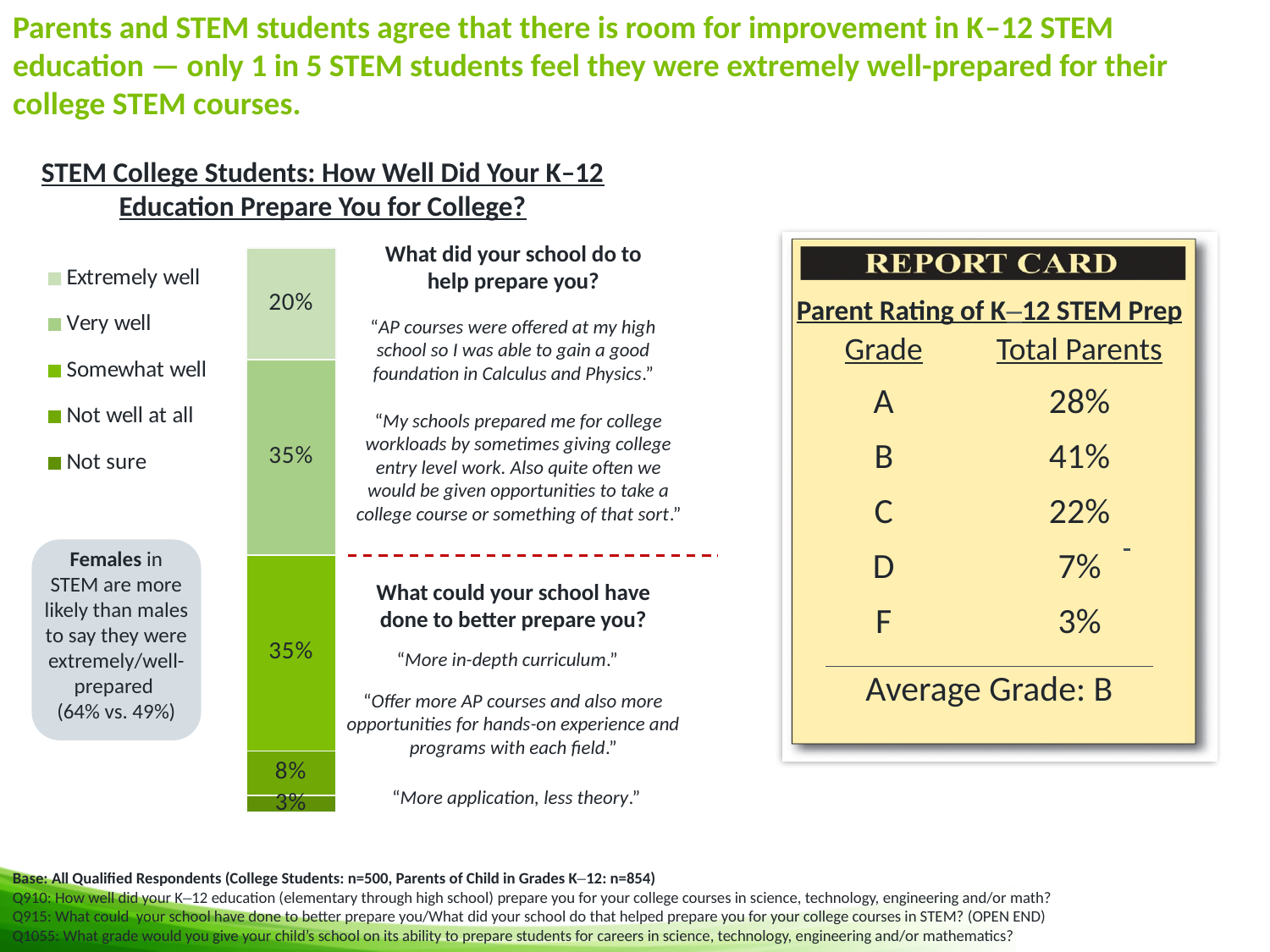
How many bars are plotted in the stacked bar chart? 1 What type of chart is used to show how well K–12 education prepared STEM college students? Stacked bar chart In the stacked bar chart, which is larger: the 'Extremely well' share or the 'Not well at all' share? Extremely well In the stacked bar chart, what is the difference between the 'Extremely well' share and the 'Not well at all' share? 12 percentage points In the stacked bar chart, what percentage of STEM college students answered 'Not well at all'? 8% In the stacked bar chart, what percentage of STEM college students answered 'Very well'? 35% In the stacked bar chart, what is the difference between the 'Very well' share and the 'Extremely well' share? 15 percentage points Which response category has the smallest share in the stacked bar chart? Not sure In the stacked bar chart, what percentage of STEM college students said their K–12 education prepared them 'Extremely well'? 20% How many response categories does the legend of the stacked bar chart list? 5 What is the title of the stacked bar chart on the slide? STEM College Students: How Well Did Your K–12 Education Prepare You for College? In the stacked bar chart, what percentage of STEM college students answered 'Not sure'? 3%